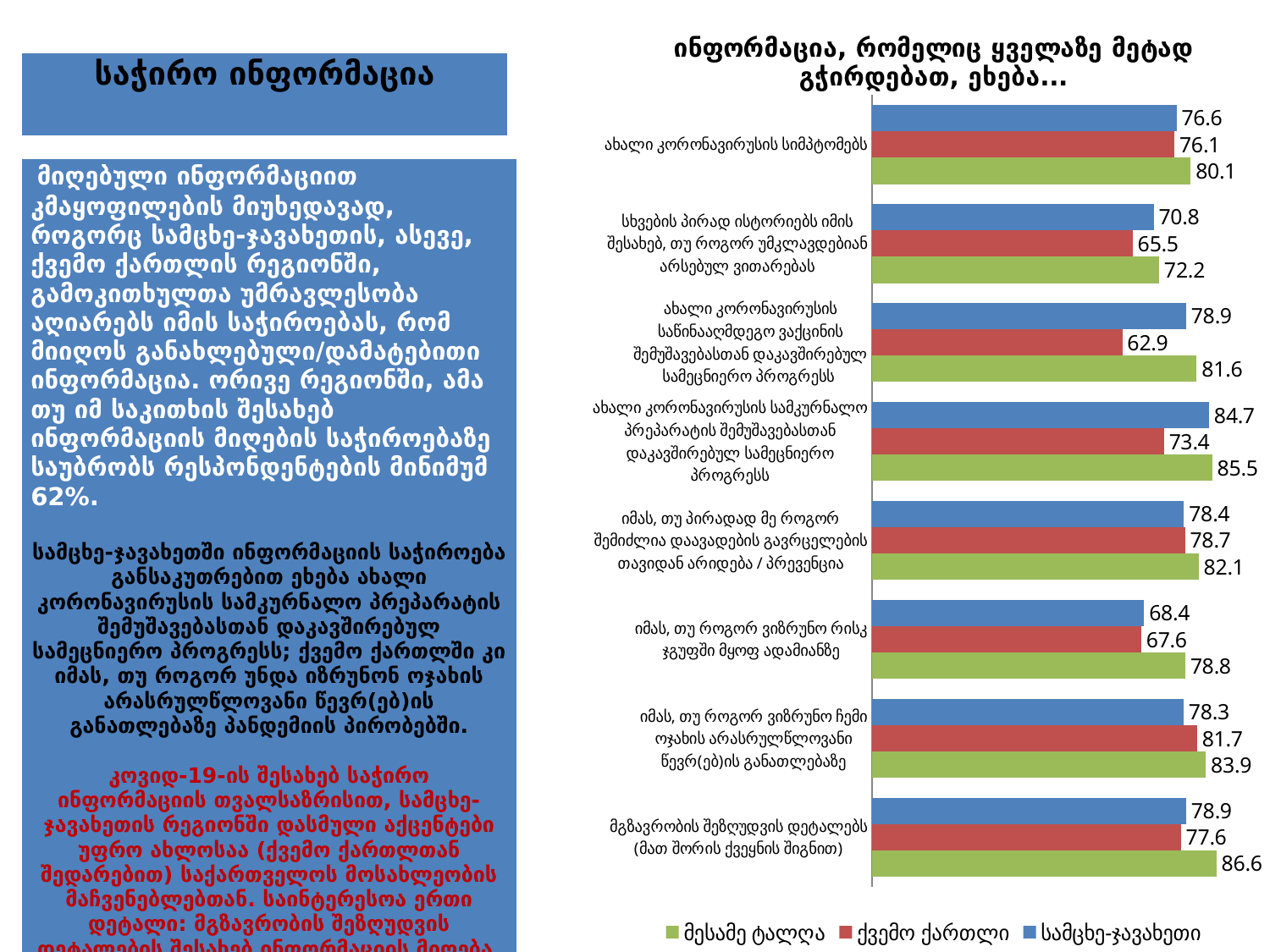
Which category has the highest value for the მესამე ტალღა series? მგზავრობის შეზღუდვის დეტალებს (მათ შორის ქვეყნის შიგნით) What is the value for ქვემო ქართლი in the category მგზავრობის შეზღუდვის დეტალებს (მათ შორის ქვეყნის შიგნით)? 77.6 What type of chart is shown on the slide? bar chart In the category იმას, თუ როგორ ვიზრუნო ჩემი ოჯახის არასრულწლოვანი წევრ(ებ)ის განათლებაზე, which is larger: the value for სამცხე-ჯავახეთი or for ქვემო ქართლი? ქვემო ქართლი How many series does the chart legend list? 3 What is the value for სამცხე-ჯავახეთი in the category ახალი კორონავირუსის სიმპტომებს? 76.6 What is the value for მესამე ტალღა in the category იმას, თუ როგორ ვიზრუნო რისკ ჯგუფში მყოფ ადამიანზე? 78.8 What colour represents the მესამე ტალღა series in the chart? green Which category has the lowest value for the ქვემო ქართლი series? ახალი კორონავირუსის საწინააღმდეგო ვაქცინის შემუშავებასთან დაკავშირებულ სამეცნიერო პროგრესს Which category has the highest value for the სამცხე-ჯავახეთი series? ახალი კორონავირუსის სამკურნალო პრეპარატის შემუშავებასთან დაკავშირებულ სამეცნიერო პროგრესს How many categories are shown on the chart? 8 What is the difference between the მესამე ტალღა and ქვემო ქართლი values in the category ახალი კორონავირუსის საწინააღმდეგო ვაქცინის შემუშავებასთან დაკავშირებულ სამეცნიერო პროგრესს? 18.7